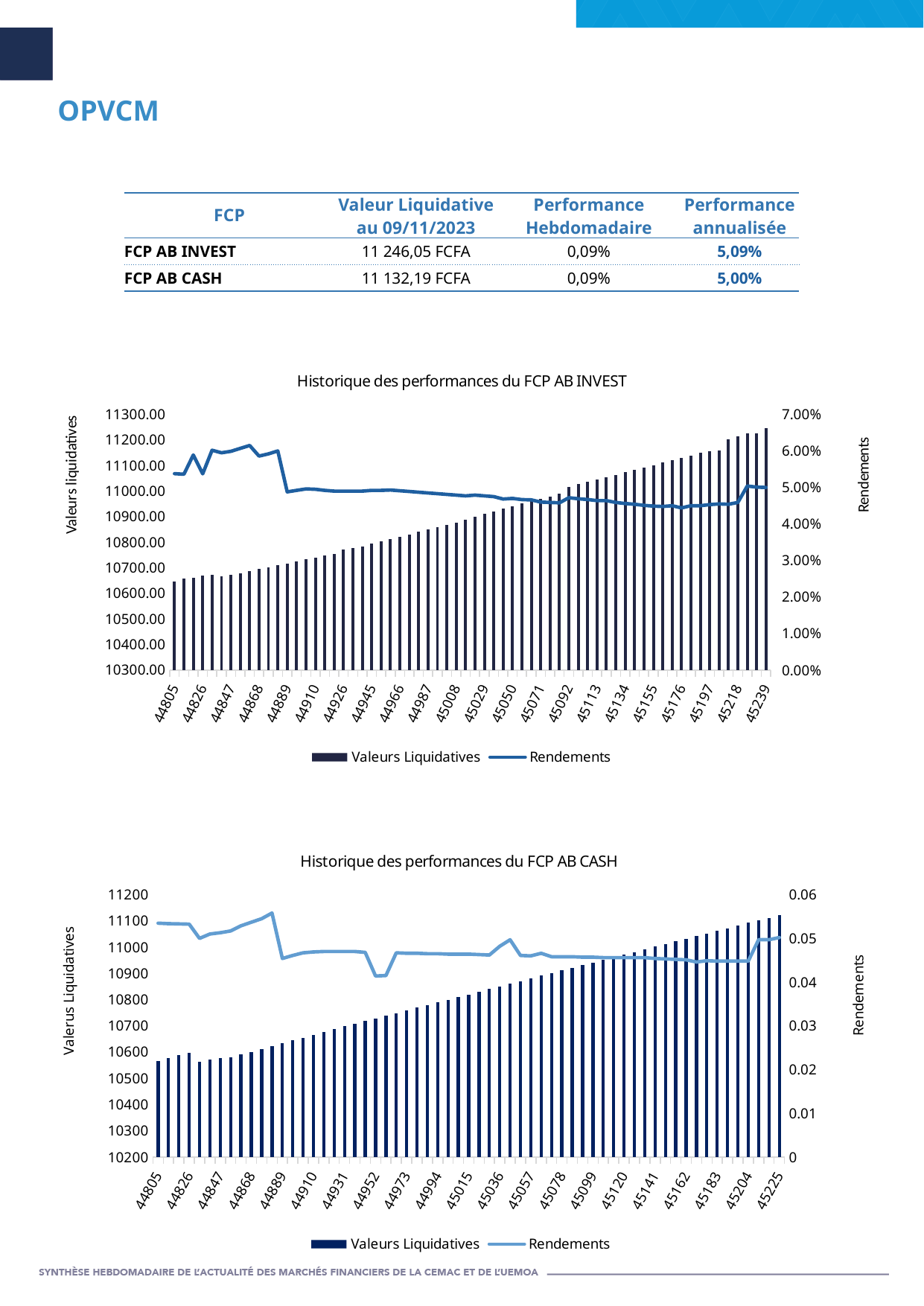
What kind of chart is 'Historique des performances du FCP AB CASH'? A combined bar and line chart In the chart 'Historique des performances du FCP AB CASH', is the Valeurs Liquidatives value at 45225 greater or less than 11000? greater In the chart 'Historique des performances du FCP AB INVEST', which series is drawn as a line? Rendements In the chart 'Historique des performances du FCP AB CASH', which is larger, the Valeurs Liquidatives bar at 44805 or at 45225? 45225 In the chart 'Historique des performances du FCP AB INVEST', is the Rendements value at 44805 greater or less than 5.00%? greater In the chart 'Historique des performances du FCP AB INVEST', do the Valeurs Liquidatives bars rise or fall along the x axis? Rise In the chart 'Historique des performances du FCP AB INVEST', is the Valeurs Liquidatives value at 45239 greater or less than 11200.00? greater What kind of chart is 'Historique des performances du FCP AB INVEST'? A combined bar and line chart In the chart 'Historique des performances du FCP AB CASH', what is the title of the right-hand vertical axis? Rendements In the chart 'Historique des performances du FCP AB INVEST', which x-axis label has the highest Valeurs Liquidatives bar? 45239 In the chart 'Historique des performances du FCP AB INVEST', how many series does the legend list? 2